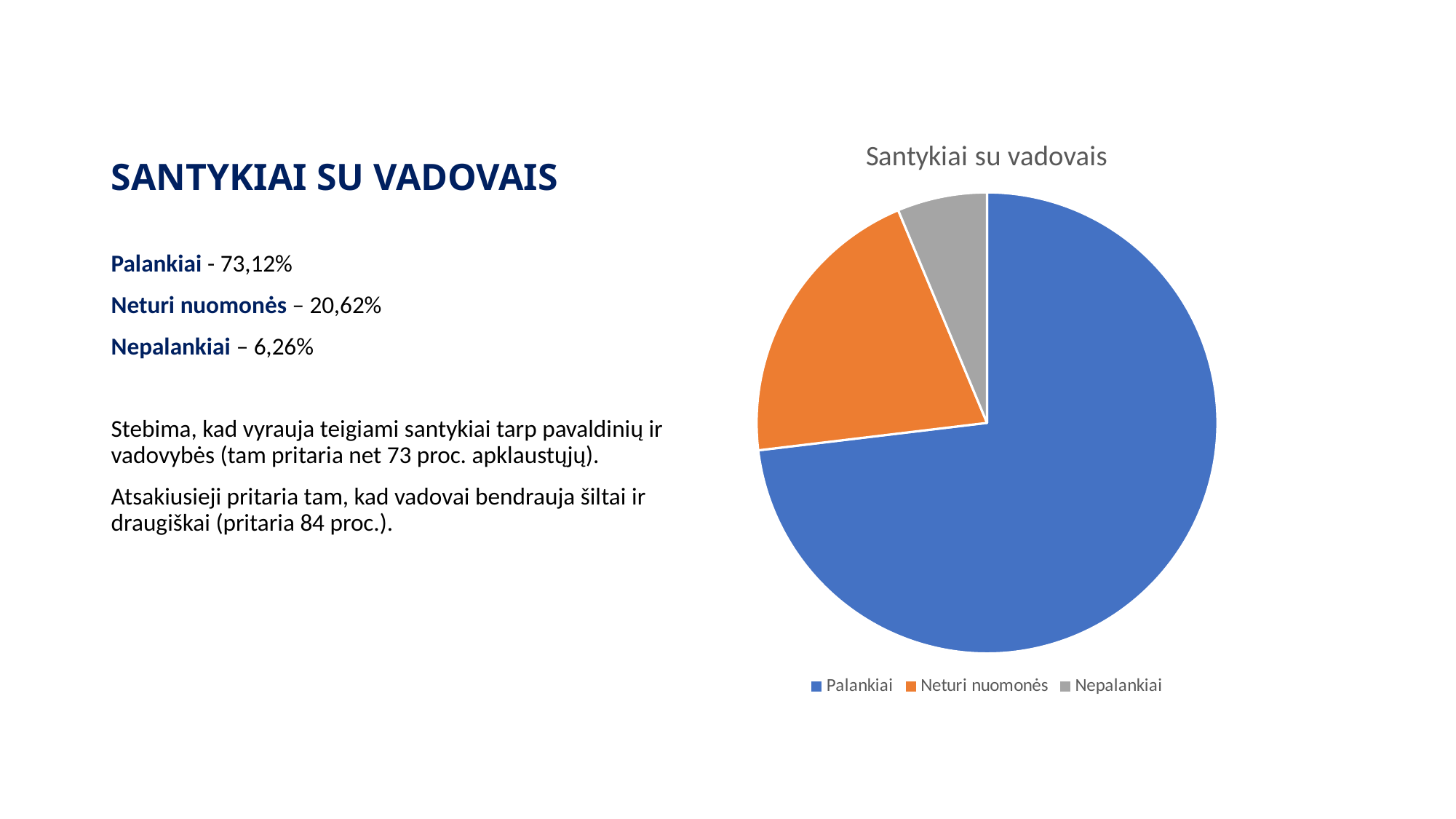
What kind of chart is shown on the slide? pie chart How many slices does the pie chart have? 3 Which category has the largest slice of the pie? Palankiai What share of the pie does Palankiai represent, according to the slide? 73,12% What is the title of the chart? Santykiai su vadovais What share of the pie does Nepalankiai represent, according to the slide? 6,26% What share of the pie does Neturi nuomonės represent, according to the slide? 20,62% Which category has the smallest slice of the pie? Nepalankiai Which colour represents Neturi nuomonės in the pie chart? orange How many entries does the chart legend list? 3 What is the difference between the Palankiai share and the Neturi nuomonės share? 52,50% Which slice is larger, Neturi nuomonės or Nepalankiai? Neturi nuomonės